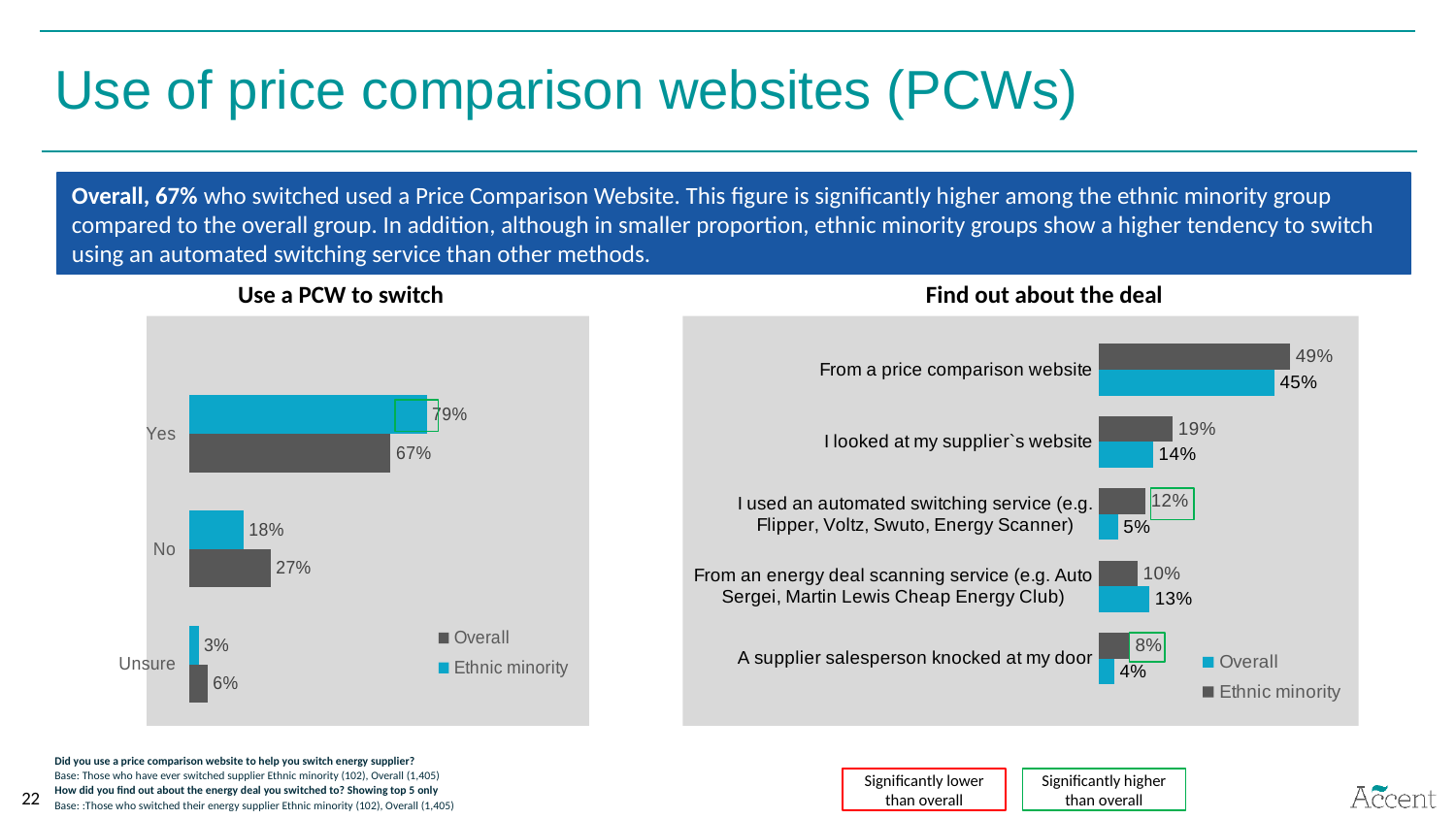
In the 'Use a PCW to switch' chart, what is the difference between the Overall and Ethnic minority values for 'Unsure'? 3% What type of chart is 'Use a PCW to switch'? Bar chart In the 'Use a PCW to switch' chart, how many categories are shown? 3 In the 'Find out about the deal' chart, what is the Ethnic minority value for 'I used an automated switching service (e.g. Flipper, Voltz, Swuto, Energy Scanner)'? 12% How many series does the legend of the 'Find out about the deal' chart list? 2 In the 'Find out about the deal' chart, what is the Overall value for 'From a price comparison website'? 45% In the 'Find out about the deal' chart, is the Overall value larger for 'From an energy deal scanning service (e.g. Auto Sergei, Martin Lewis Cheap Energy Club)' or for 'A supplier salesperson knocked at my door'? From an energy deal scanning service (e.g. Auto Sergei, Martin Lewis Cheap Energy Club) In the 'Use a PCW to switch' chart, what is the value for Overall for 'No'? 27% In the 'Use a PCW to switch' chart, which category has the lowest value for Ethnic minority? Unsure In the 'Find out about the deal' chart, which category has the highest Ethnic minority value? From a price comparison website In the 'Find out about the deal' chart, what is the difference between the Ethnic minority and Overall values for 'I looked at my supplier`s website'? 5% In the 'Use a PCW to switch' chart, what is the value for Ethnic minority for 'Yes'? 79%